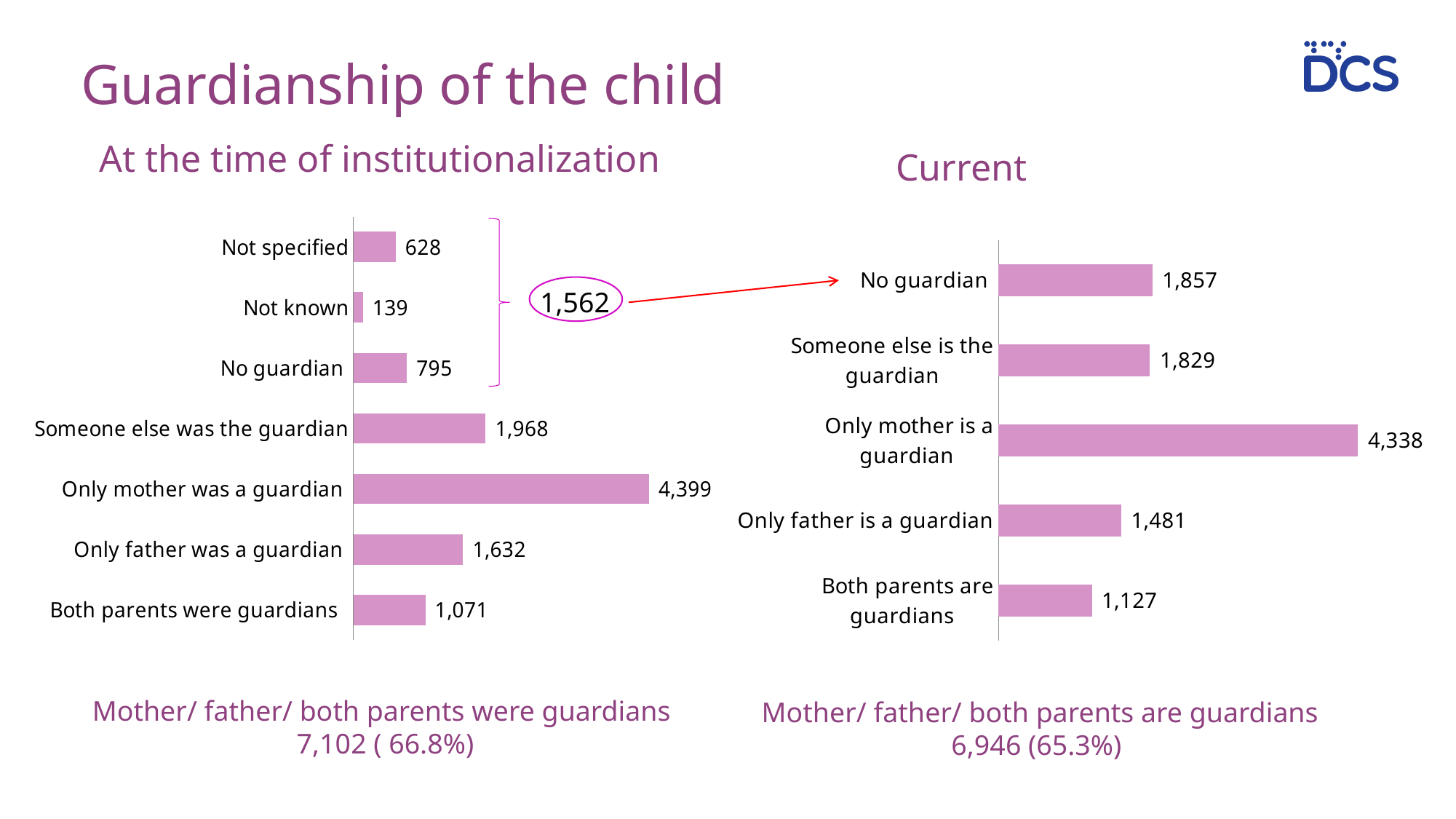
In the 'Current' chart, what is the value for 'Only father is a guardian'? 1,481 In the 'At the time of institutionalization' chart, which category has the lowest value? Not known In the 'At the time of institutionalization' chart, what is the value for 'Only mother was a guardian'? 4,399 How many categories are shown in the 'Current' chart? 5 In the 'Current' chart, which category has the lowest value? Both parents are guardians In the 'At the time of institutionalization' chart, which is larger: 'Someone else was the guardian' or 'Only father was a guardian'? Someone else was the guardian In the 'Current' chart, what is the difference between 'Only mother is a guardian' and 'Only father is a guardian'? 2,857 What type of chart is the 'Current' chart? Bar chart How many categories are shown in the 'At the time of institutionalization' chart? 7 In the 'At the time of institutionalization' chart, what is the value for 'Not known'? 139 In the 'Current' chart, which category has the highest value? Only mother is a guardian In the 'At the time of institutionalization' chart, what is the difference between 'Only father was a guardian' and 'Both parents were guardians'? 561